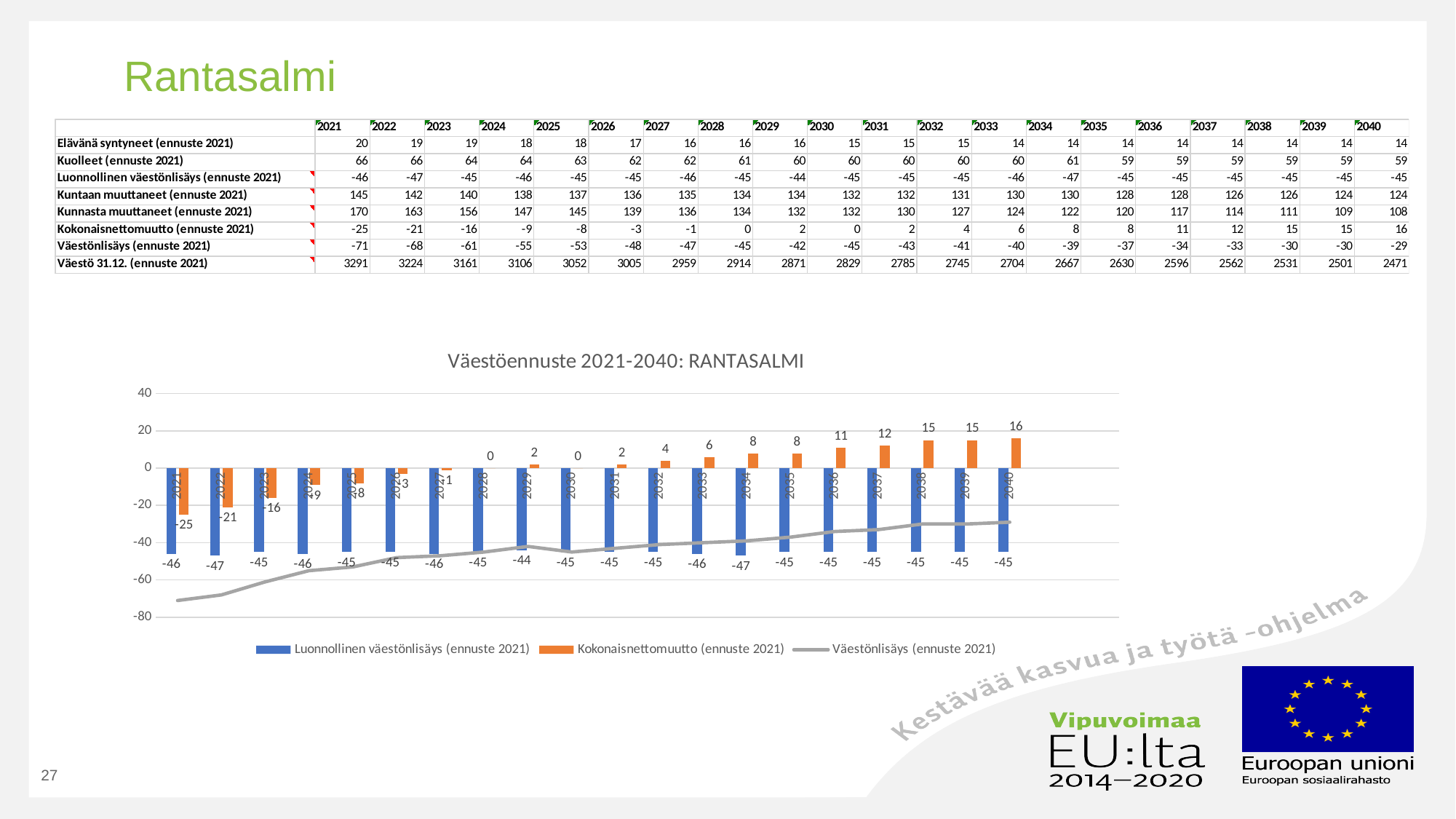
What is the value of Kokonaisnettomuutto (ennuste 2021) for 2021 in the chart? -25 In which year is Kokonaisnettomuutto (ennuste 2021) highest in the chart? 2040 Which is larger in the chart: Kokonaisnettomuutto (ennuste 2021) for 2036 or for 2037? 2037 Does Kokonaisnettomuutto (ennuste 2021) rise or fall from 2021 to 2040 in the chart? rise In which year is Kokonaisnettomuutto (ennuste 2021) lowest in the chart? 2021 How many years are shown on the x axis of the chart? 20 What is the difference between the Kokonaisnettomuutto (ennuste 2021) values for 2040 and 2021 in the chart? 41 What is the value of Kokonaisnettomuutto (ennuste 2021) for 2040 in the chart? 16 Is the Väestönlisäys (ennuste 2021) line value for 2021 greater or less than -60 in the chart? less How many series does the chart legend list? 3 What is the value of Luonnollinen väestönlisäys (ennuste 2021) for 2029 in the chart? -44 What is the title of the chart on the slide? Väestöennuste 2021-2040: RANTASALMI